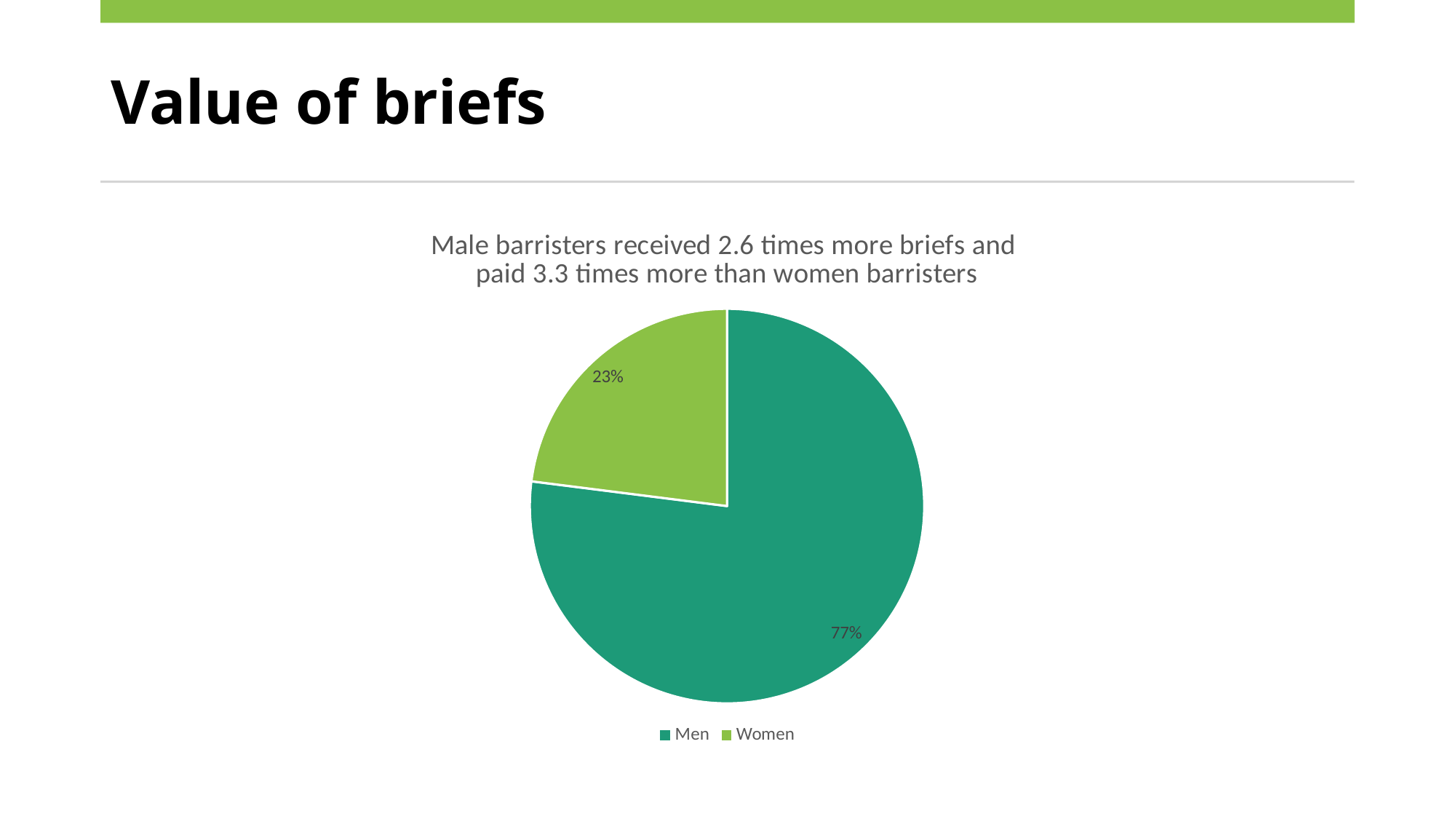
Is the value for Women greater or less than 50%? less What kind of chart is shown on the slide? Pie chart What is the difference in percentage points between the Men and Women slices? 54 percentage points How many categories are shown in the pie chart? 2 Which category has the smallest slice of the pie? Women What share of the pie does the Men slice represent? 77% Which category has the largest slice of the pie? Men Which legend entry is shown in light green? Women What share of the pie does the Women slice represent? 23% What is the title of the chart? Male barristers received 2.6 times more briefs and paid 3.3 times more than women barristers Which slice is larger, Men or Women? Men